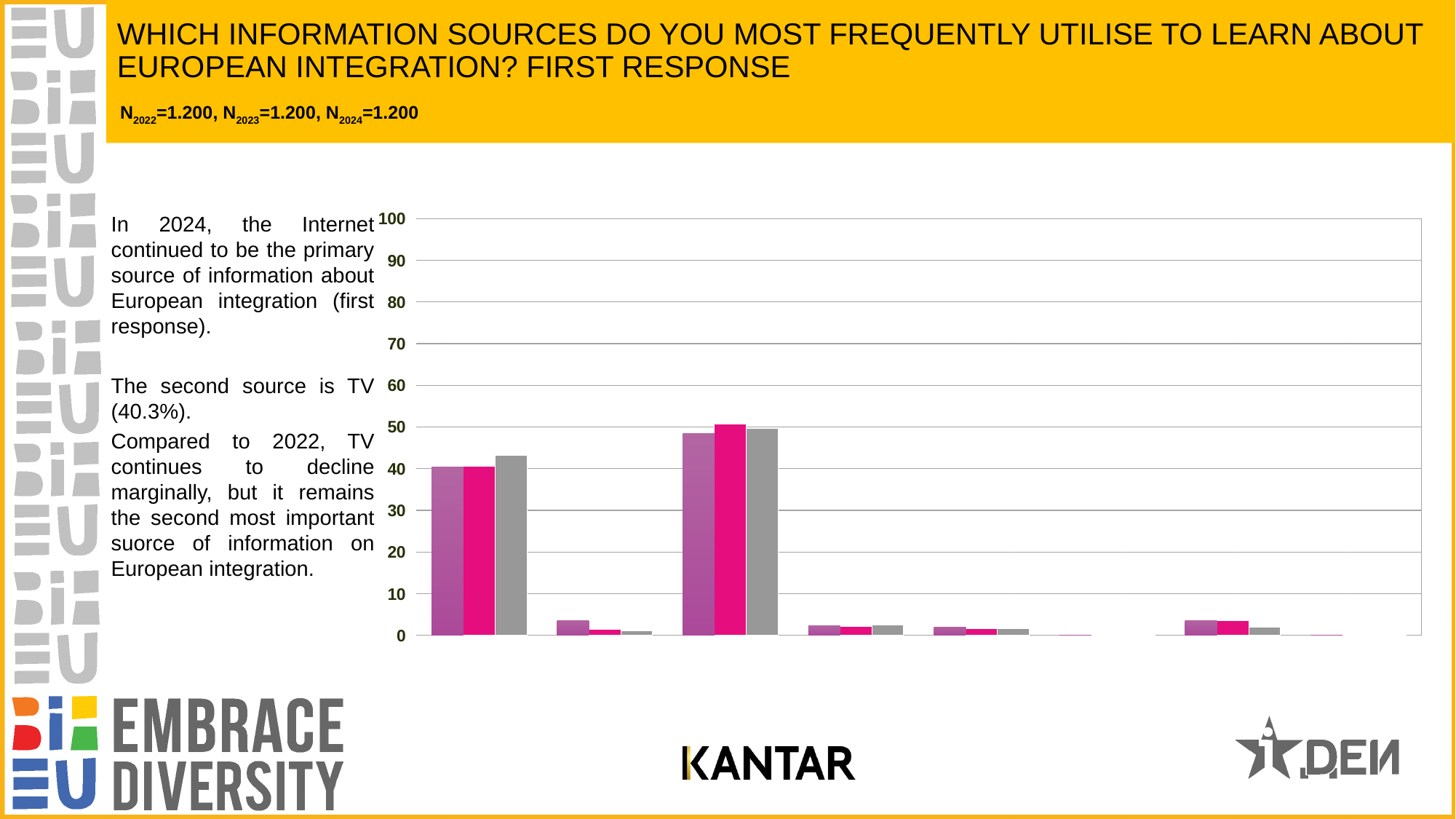
What kind of chart is shown on the slide? bar chart Is the tallest bar in the second group of bars from the left greater or less than 60? less Is the grey bar in the first group of bars from the left greater or less than 30? greater Are the bars in the third group from the left greater or less than 10? less Which group of bars reaches higher values: the first group from the left or the second group from the left? the second group from the left What is the interval between the tick marks on the vertical axis? 10 How many bars are there in each group of bars on the chart? 3 What is the highest value shown on the vertical axis of the chart? 100